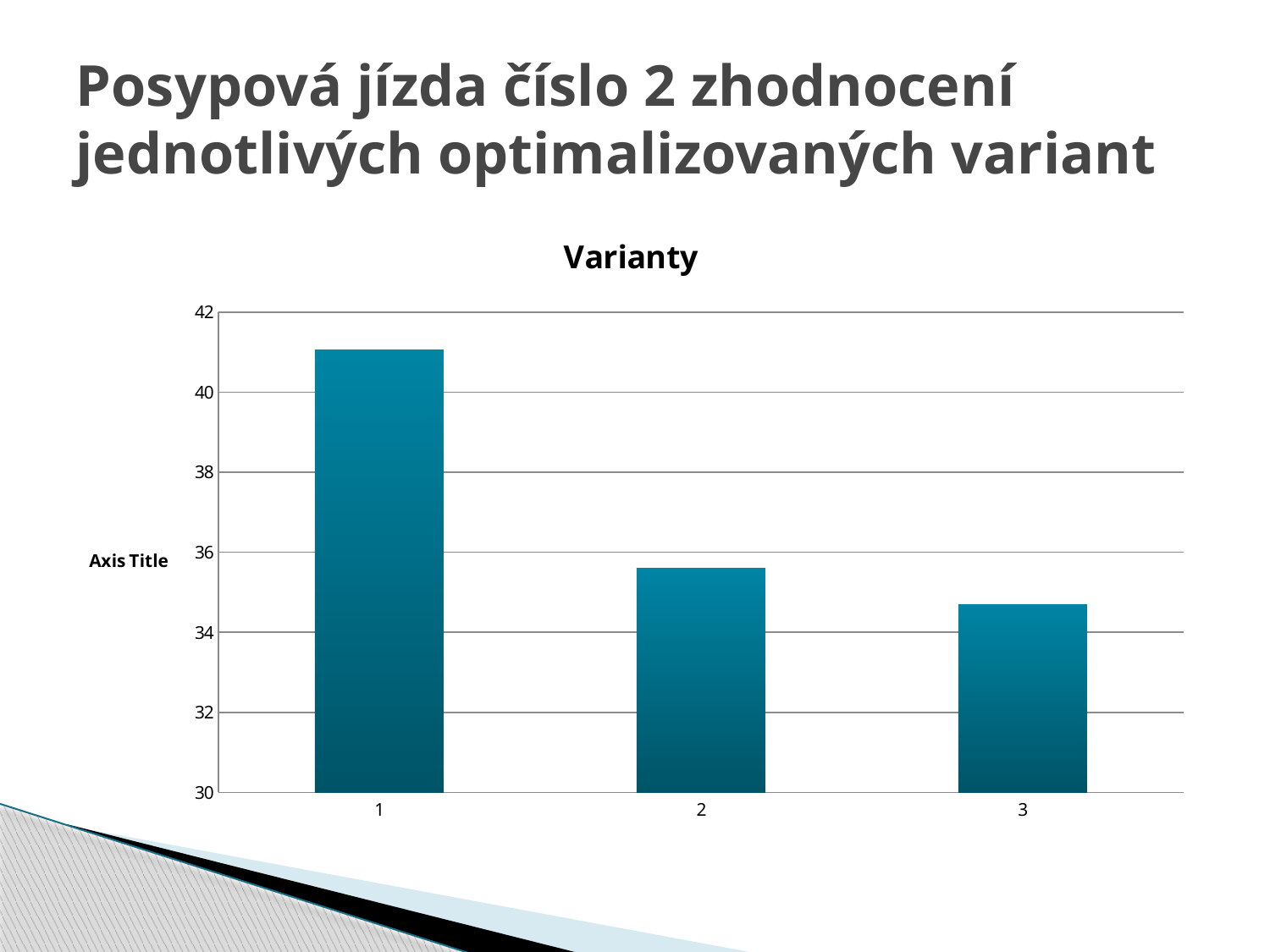
Which has the larger value, category 1 or category 2? 1 Do the values rise or fall from category 1 to category 3? fall Is the value for category 2 greater or less than 36? less How many categories are plotted in the Varianty chart? 3 What is the label on the vertical axis of the chart? Axis Title Which category has the highest value in the Varianty chart? 1 Which has the larger value, category 2 or category 3? 2 What is the title of the chart? Varianty Is the value for category 3 greater or less than 34? greater What kind of chart is shown on the slide? bar chart Which category has the lowest value in the Varianty chart? 3 Is the value for category 1 greater or less than 40? greater